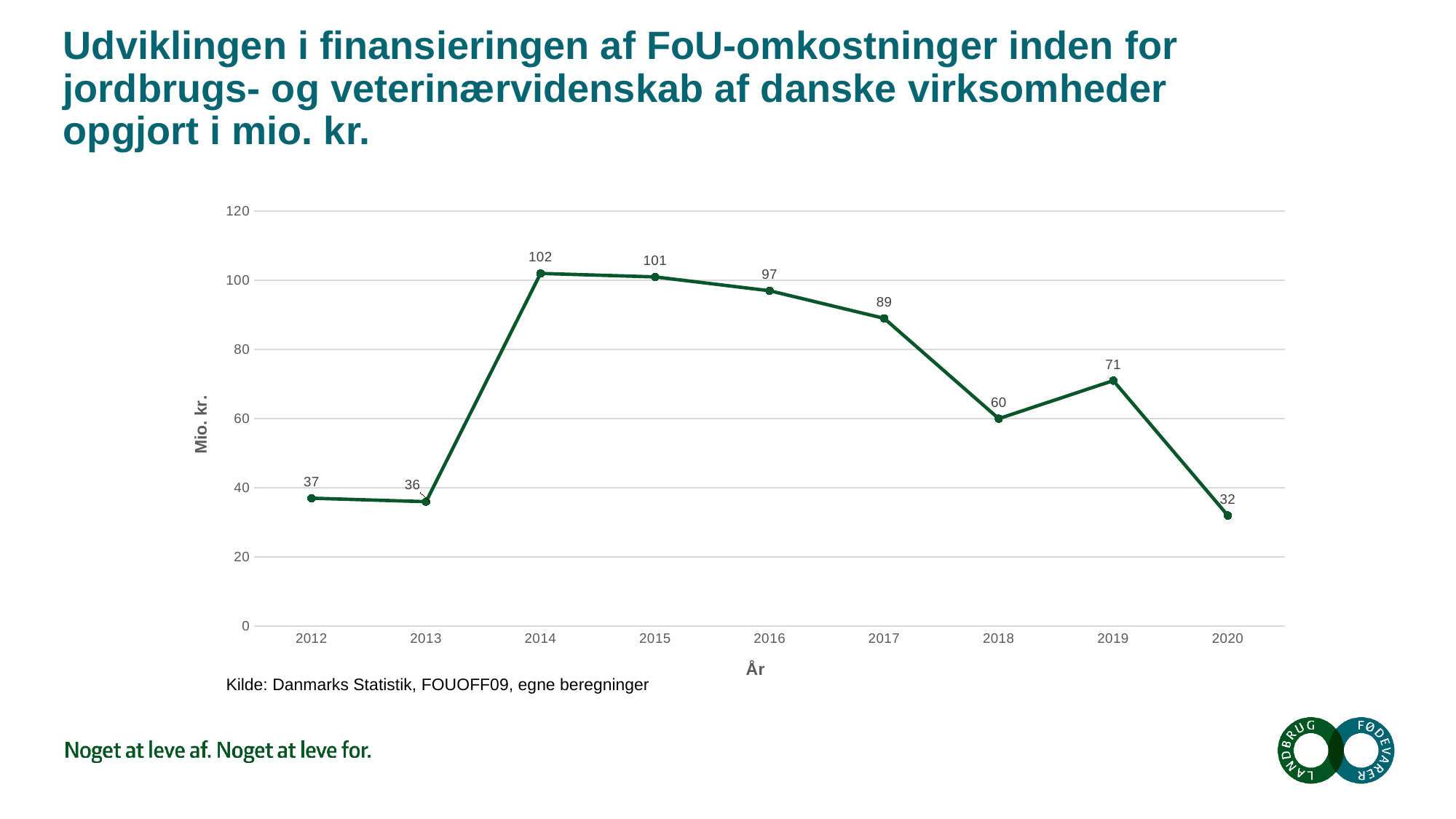
What is the value for 2020? 32 How many years are plotted on the x axis? 9 Which is larger, the value for 2017 or the value for 2019? 2017 What is the label of the y axis? Mio. kr. Is the value for 2016 greater or less than 80? greater What is the value for 2018? 60 Do the values rise or fall from 2017 to 2018? fall What is the value for 2014? 102 What kind of chart is shown? line chart Which year has the lowest value? 2020 Which year has the highest value? 2014 What is the difference between the values for 2014 and 2020? 70